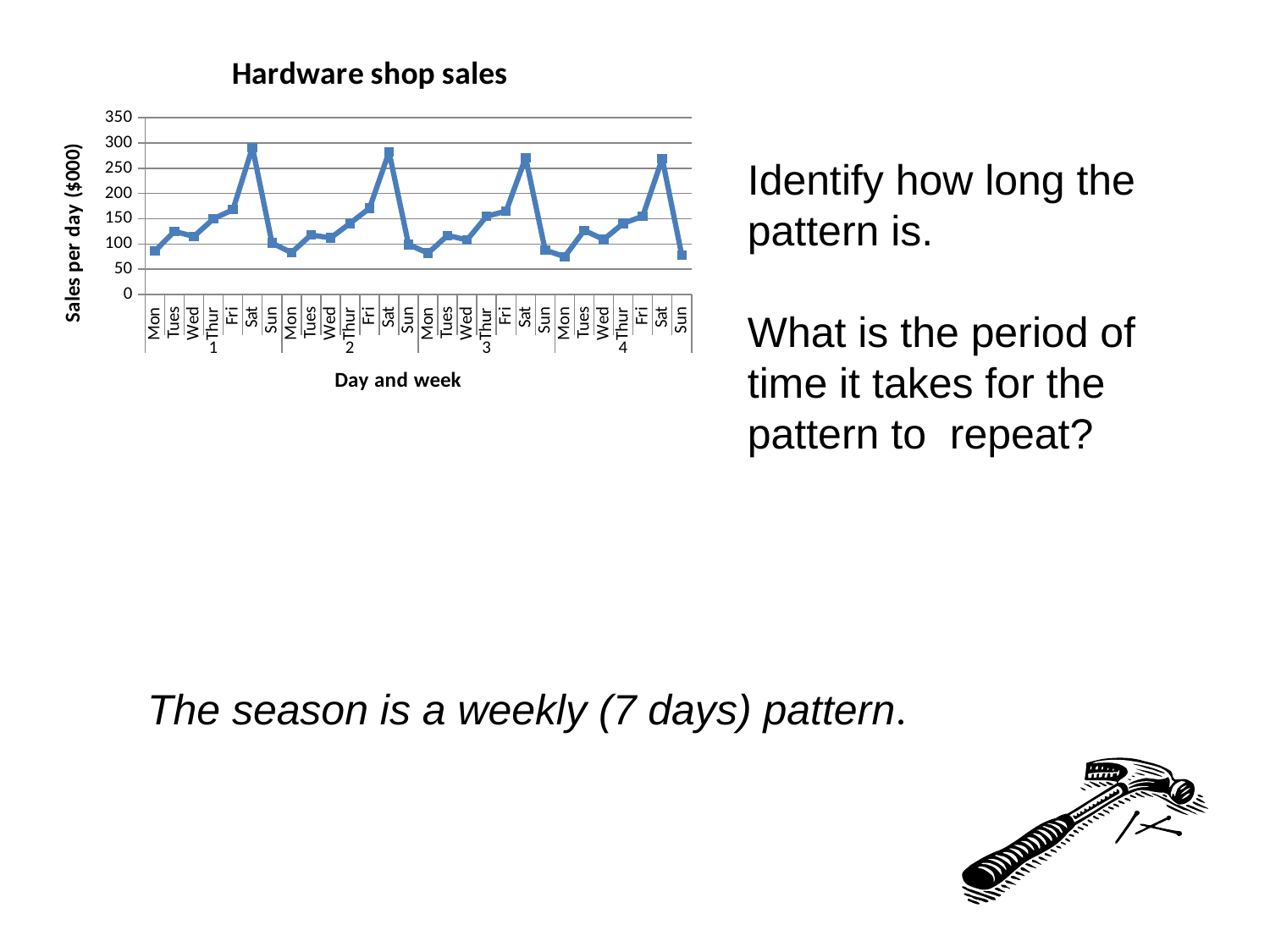
What is the title of the chart? Hardware shop sales Is the value for Wed in week 2 greater or less than 150? less Within week 1, do sales rise or fall from Mon to Sat? rise What kind of chart is shown on the slide? line chart What is the label on the vertical axis of the chart? Sales per day ($000) How many data points are plotted on the chart in total? 28 Is the value for Mon in week 1 greater or less than 100? less Is the value for Sun in week 4 greater or less than 100? less Which has the higher sales value, Sat in week 1 or Sun in week 1? Sat in week 1 How many weeks of data are plotted on the chart? 4